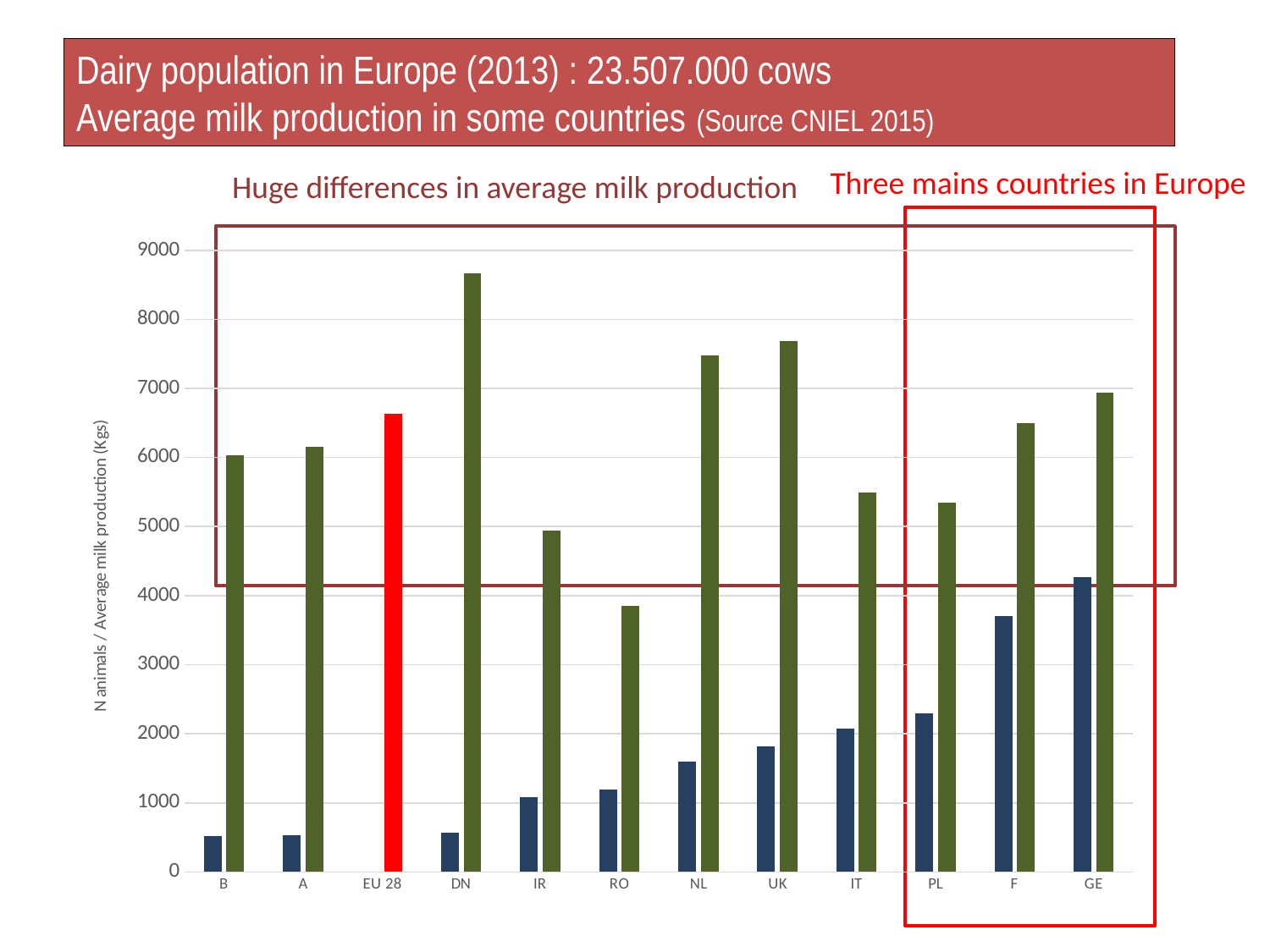
Is the green bar for DN greater or less than 8000? greater What is the label of the vertical axis? N animals / Average milk production (Kgs) Is the blue bar for GE greater or less than 4000? greater Is the green bar for RO greater or less than 4000? less Which has the taller green bar, F or GE? GE How many countries/categories are shown on the x axis of the chart? 12 What kind of chart is shown on the slide? bar chart Which category is shown with a red bar? EU 28 Which category has the tallest blue bar? GE Which category has the shortest green bar (lowest average milk production)? RO Which category has the tallest green bar (highest average milk production)? DN